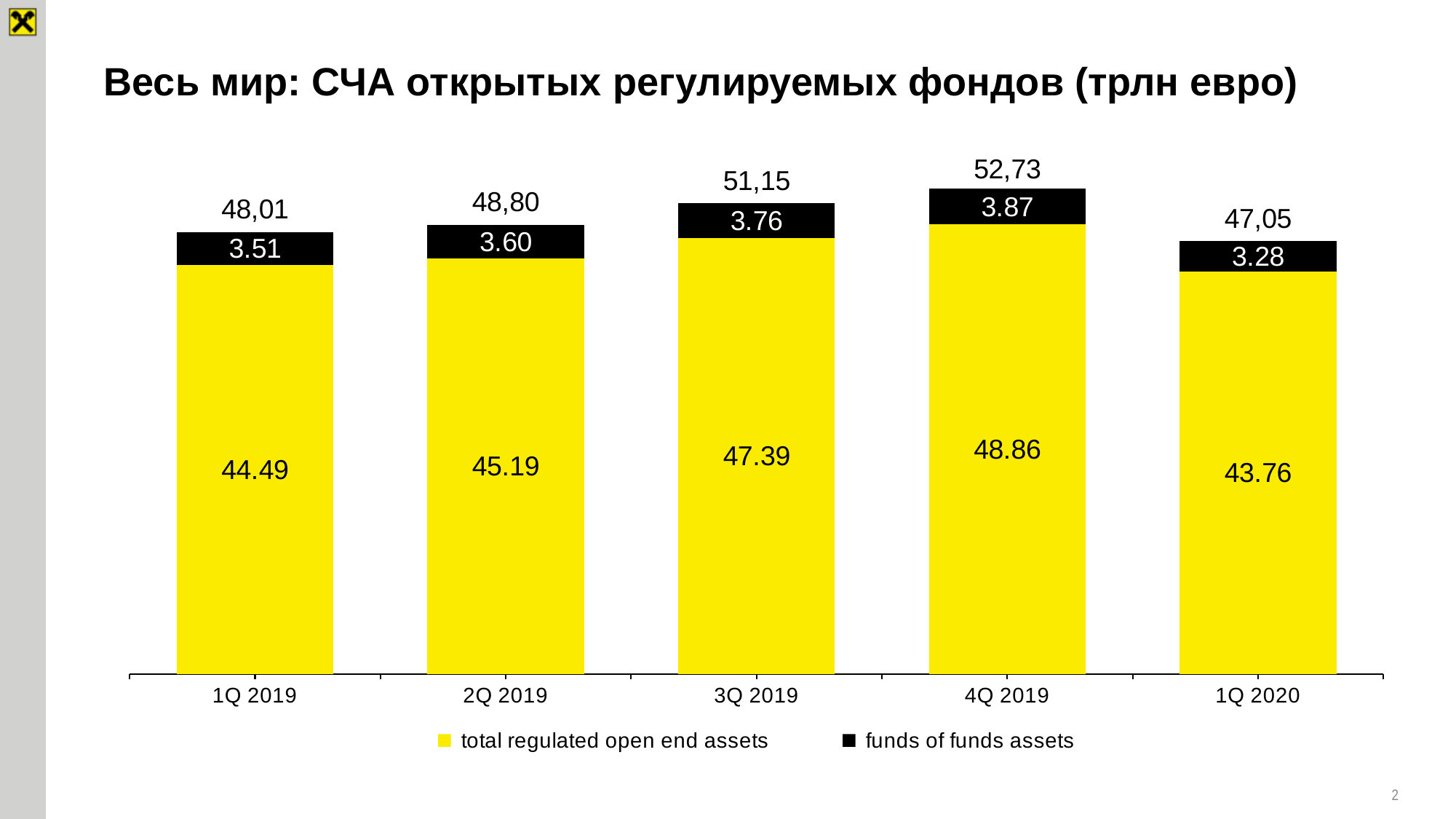
What is the value of total regulated open end assets for 3Q 2019? 47.39 Which quarter has the highest total regulated open end assets? 4Q 2019 Which is larger: funds of funds assets in 3Q 2019 or in 2Q 2019? 3Q 2019 What is the value of funds of funds assets for 1Q 2020? 3.28 What is the difference in total regulated open end assets between 2Q 2019 and 1Q 2019? 0.70 What is the total shown above the stacked bar for 4Q 2019? 52,73 What kind of chart is shown on the slide? Stacked bar chart How many quarters are shown on the x axis? 5 Which colour represents funds of funds assets in the chart? Black Which quarter has the lowest funds of funds assets? 1Q 2020 Do the stacked bar totals rise or fall from 1Q 2019 to 4Q 2019? Rise How many series does the legend list? 2